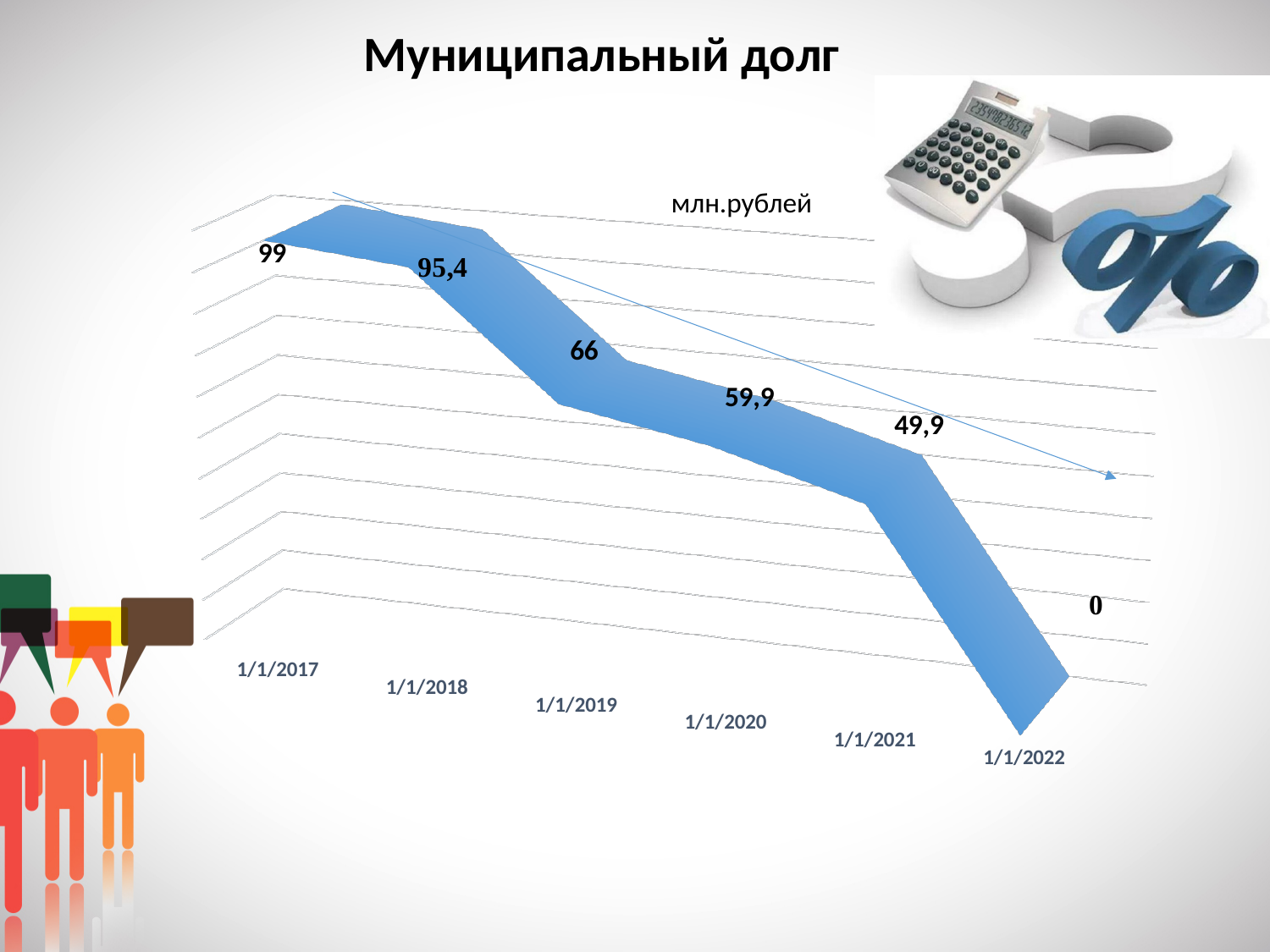
Which is larger, the value for 1/1/2020 or the value for 1/1/2021? 1/1/2020 What is the value shown for 1/1/2020? 59,9 What is the value shown for 1/1/2019? 66 What is the value shown for 1/1/2022? 0 What is the value shown for 1/1/2021? 49,9 What is the value shown for 1/1/2018? 95,4 Which date has the lowest value on the chart? 1/1/2022 How many dates are plotted on the chart? 6 What is the municipal debt value shown for 1/1/2017? 99 Do the values rise or fall from 1/1/2017 to 1/1/2022? fall Which date has the highest value on the chart? 1/1/2017 What is the difference between the values for 1/1/2018 and 1/1/2019? 29,4